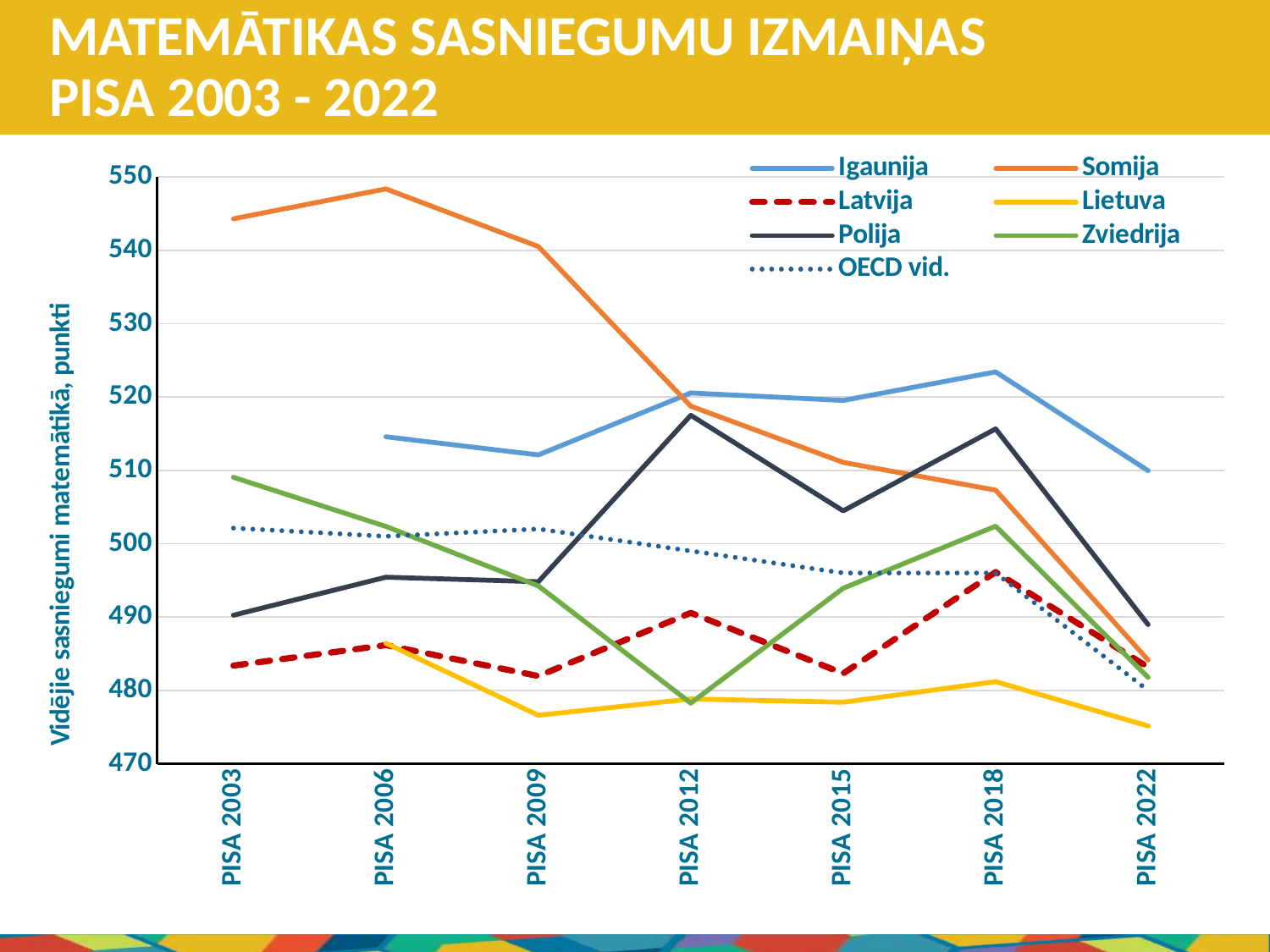
What kind of chart is shown on the slide? line chart In which PISA cycle does Igaunija reach its highest value? PISA 2018 Is the value for Somija at PISA 2006 greater or less than 540? greater Which series is drawn as a dashed red line? Latvija What is the title of the y axis? Vidējie sasniegumi matemātikā, punkti Is the value for Lietuva at PISA 2022 greater or less than 480? less How many PISA cycles are shown along the x axis? 7 Which country has the highest value at PISA 2003? Somija At PISA 2022, which is higher: Igaunija or Polija? Igaunija Does the Somija line rise or fall from PISA 2006 to PISA 2022? fall Which series has the lowest value at PISA 2022? Lietuva How many series does the legend list? 7